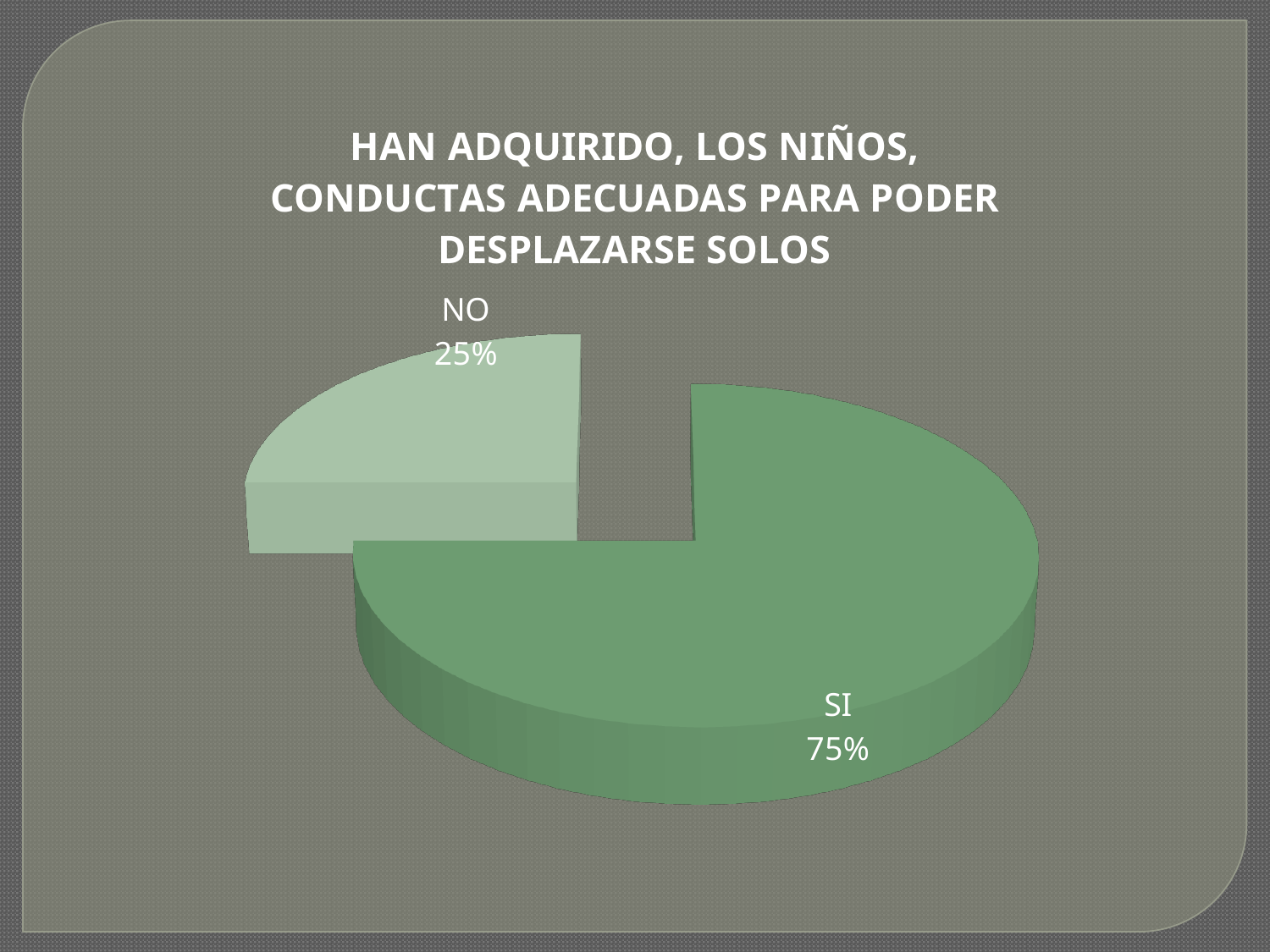
Which slice is the smallest? NO What kind of chart is shown on the slide? Pie chart Which slice is shown in the lighter green colour? NO What percentage is shown for the SI slice? 75% Which is larger, the SI slice or the NO slice? SI Which slice is the largest? SI What is the difference in percentage points between the SI and NO slices? 50 What percentage is shown for the NO slice? 25% What share of the pie does the NO slice represent? 25% How many slices does the pie chart have? 2 What is the title of the chart? HAN ADQUIRIDO, LOS NIÑOS, CONDUCTAS ADECUADAS PARA PODER DESPLAZARSE SOLOS